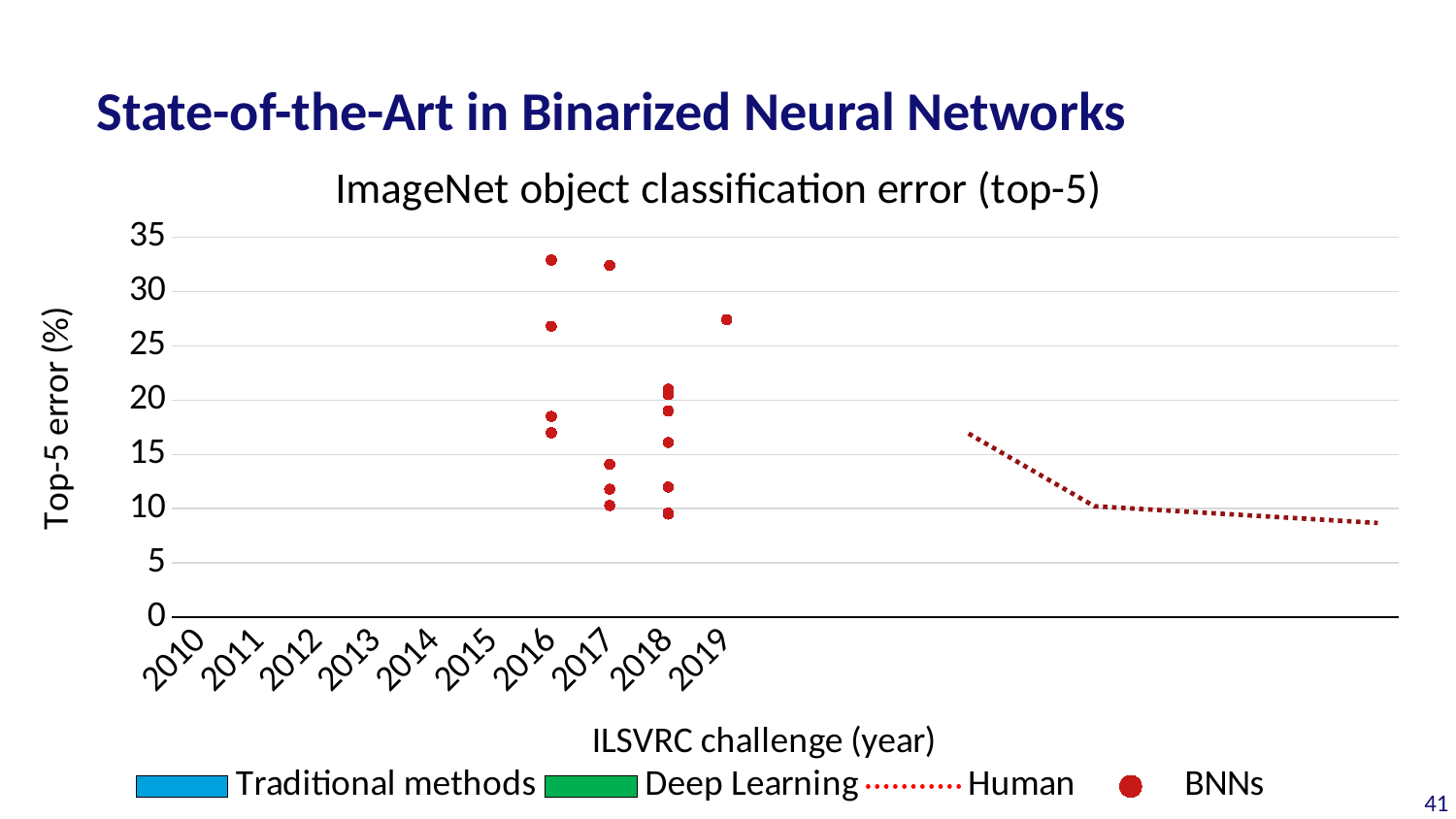
Which year has the most BNNs points plotted? 2018 What is the title of the chart? ImageNet object classification error (top-5) Is the highest BNNs point for 2018 greater or less than the highest BNNs point for 2019? less Is the highest BNNs point plotted for 2016 greater or less than 30? greater Does the Human dotted line rise or fall from left to right? fall How many years are labelled on the x axis of the chart? 10 What kind of chart is shown on the slide? scatter chart Is the value at the right end of the Human dotted line greater or less than 10? less How many series does the chart's legend list? 4 Is the value at the left end of the Human dotted line greater or less than 15? greater What is the label of the y axis? Top-5 error (%)